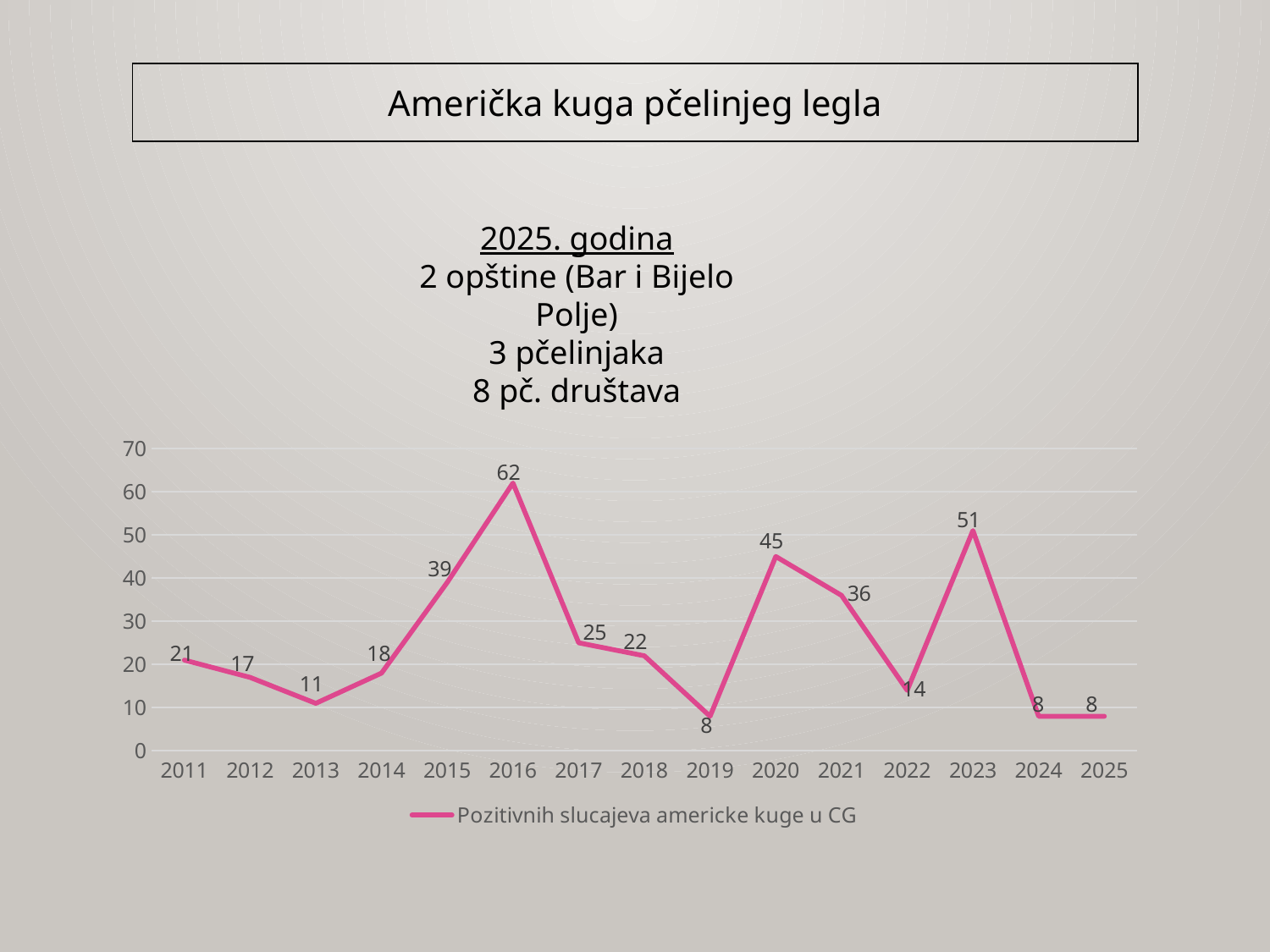
Do the values rise or fall from 2013 to 2016? rise Which is larger, the value for 2020 or the value for 2021? 2020 What is the legend entry for the plotted series? Pozitivnih slucajeva americke kuge u CG Which year has the lowest value among 2011 to 2019? 2019 What is the value for 2023? 51 What is the value for 2016? 62 Which year has the highest value? 2016 How many years are plotted on the x axis? 15 What kind of chart is shown? line chart How many series does the legend list? 1 What is the value for 2019? 8 What is the difference between the values for 2016 and 2017? 37